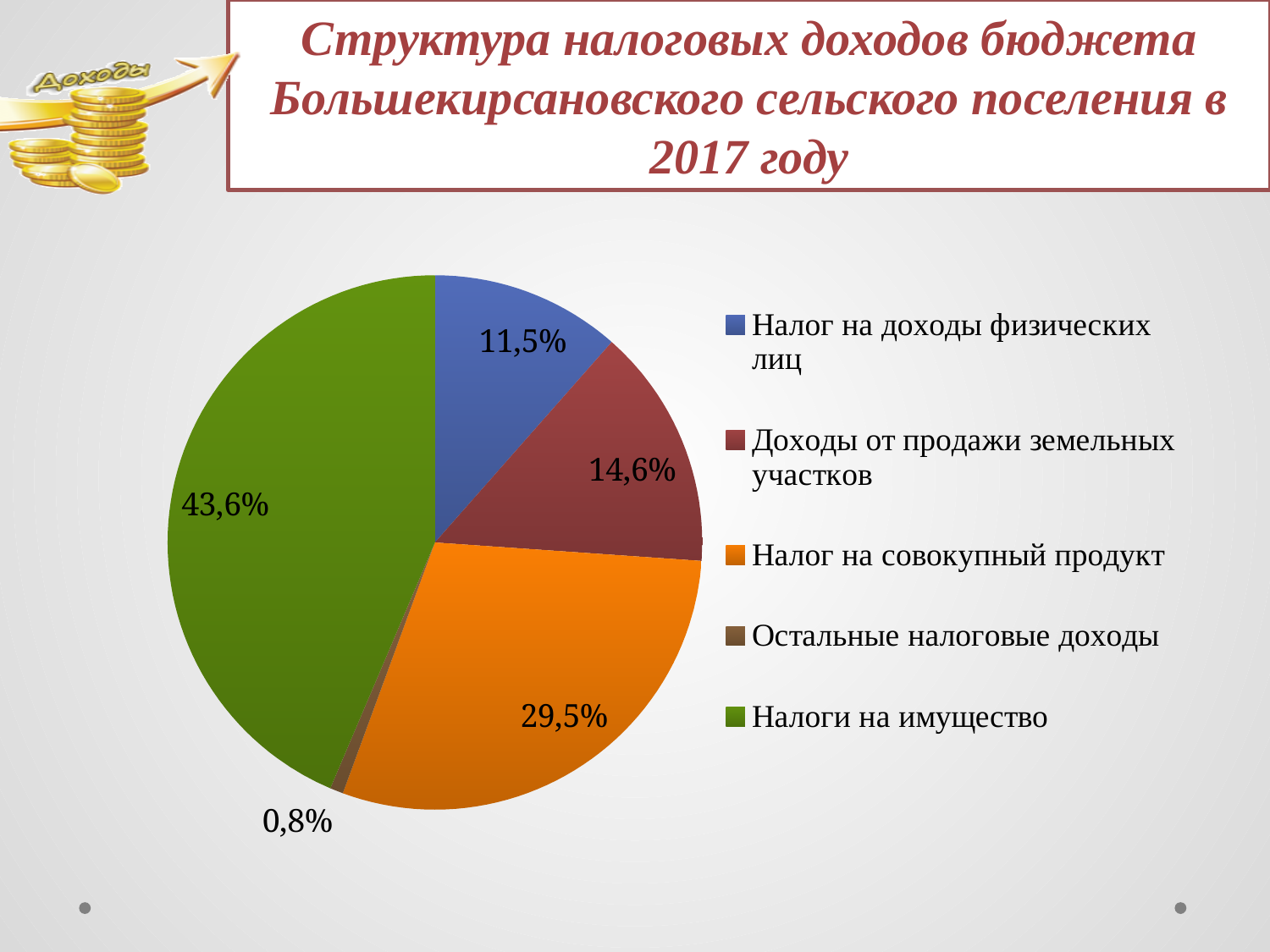
What is the value shown for "Доходы от продажи земельных участков"? 14,6% How many categories does the pie chart show? 5 What is the value shown for "Налог на доходы физических лиц"? 11,5% Which category has the largest slice of the pie? Налоги на имущество What share of the pie does "Налоги на имущество" have? 43,6% What is the difference between the shares of "Налоги на имущество" and "Налог на совокупный продукт"? 14,1% Which category has the smallest slice of the pie? Остальные налоговые доходы What is the value shown for "Налог на совокупный продукт"? 29,5% What kind of chart is shown on the slide? Pie chart What colour is the slice for "Налог на совокупный продукт"? Orange Which is larger: "Доходы от продажи земельных участков" or "Налог на доходы физических лиц"? Доходы от продажи земельных участков What is the value shown for "Остальные налоговые доходы"? 0,8%